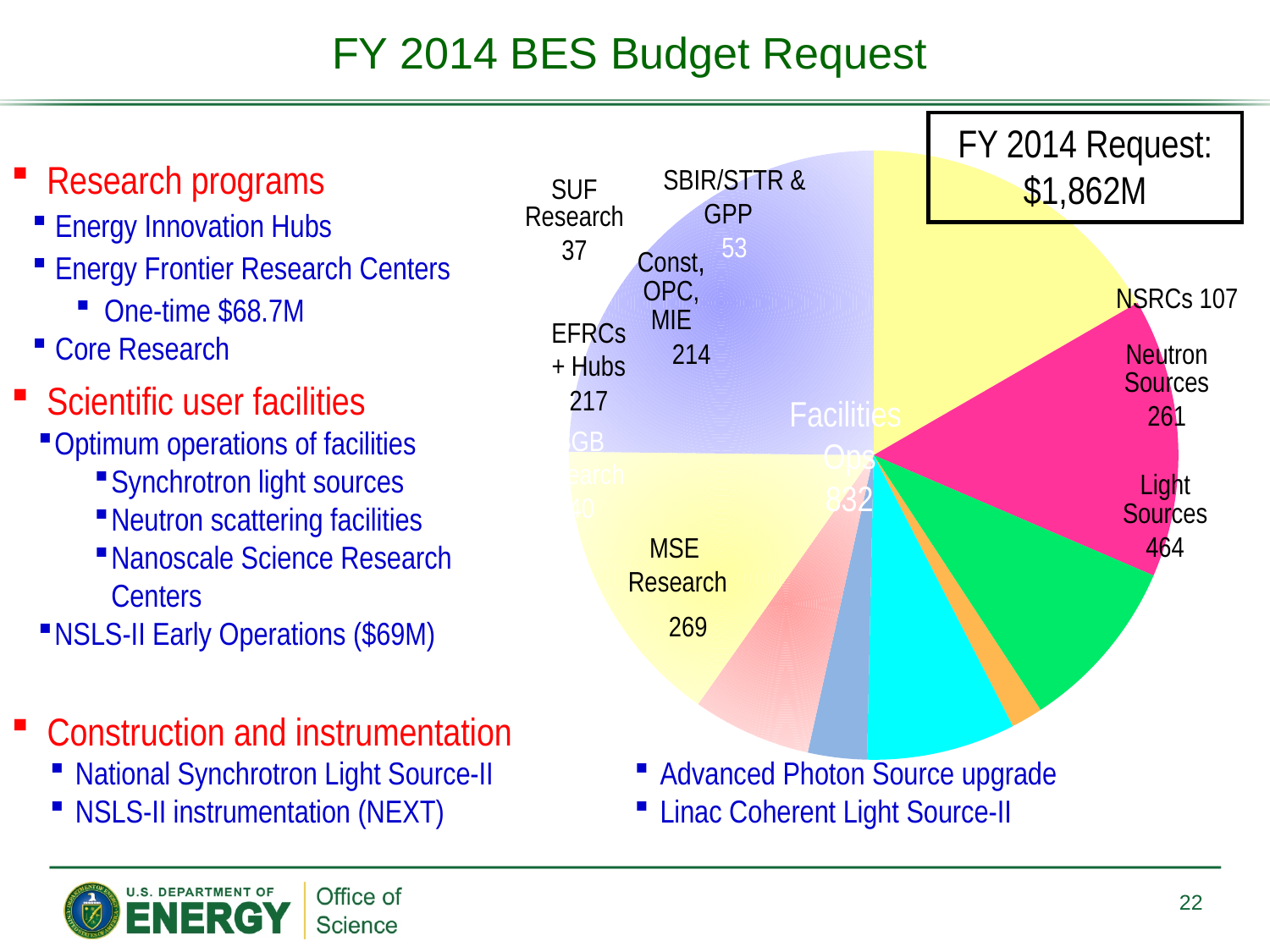
What kind of chart is shown on the slide? pie chart What value is shown for Light Sources in the pie chart? 464 What is the difference between the Light Sources value and the Neutron Sources value? 203 What value is shown for SUF Research in the pie chart? 37 What value is shown for Neutron Sources in the pie chart? 261 What value is shown for SBIR/STTR & GPP in the pie chart? 53 What value is shown for Const, OPC, MIE in the pie chart? 214 What value is shown for NSRCs in the pie chart? 107 Which is larger, MSE Research or EFRCs + Hubs? MSE Research What total FY 2014 Request amount is shown in the box next to the pie chart? $1,862M What value is shown for MSE Research in the pie chart? 269 What value is shown for EFRCs + Hubs in the pie chart? 217